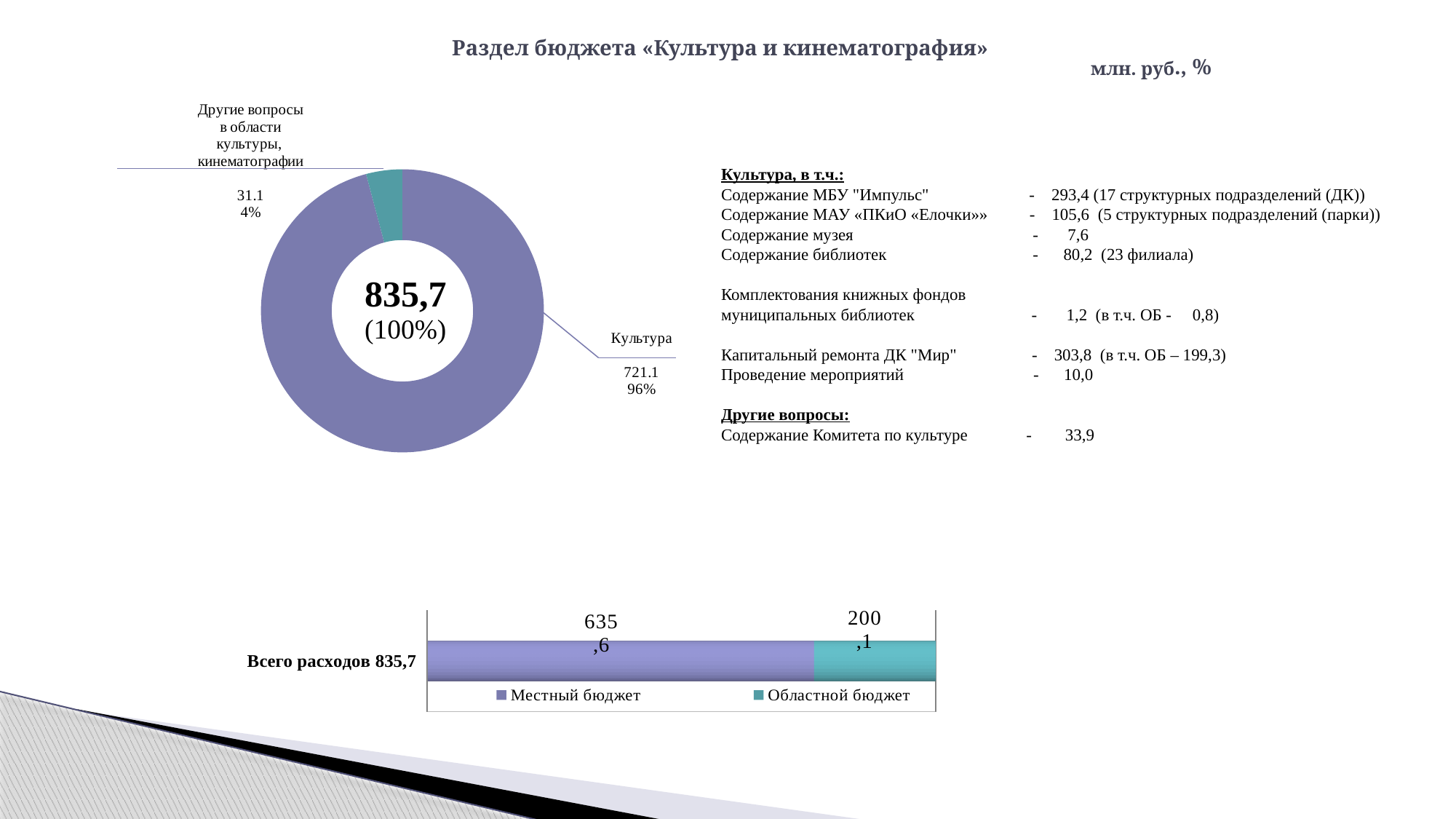
On the bar chart at the bottom of the slide, which is larger, Местный бюджет or Областной бюджет? Местный бюджет On the doughnut chart at the top left, what is the value for Другие вопросы в области культуры, кинематографии? 31.1 What kind of chart is shown at the bottom of the slide? Stacked bar chart On the bar chart at the bottom of the slide, what is the value for Местный бюджет? 635,6 On the doughnut chart at the top left, what share of the total does Другие вопросы в области культуры, кинематографии account for? 4% On the doughnut chart at the top left, which category is the largest? Культура On the doughnut chart at the top left, what is the value for Культура? 721.1 How many categories does the doughnut chart at the top left show? 2 On the bar chart at the bottom of the slide, what is the value for Областной бюджет? 200,1 On the doughnut chart at the top left, what total is shown in the centre? 835,7 How many series does the legend of the bar chart at the bottom of the slide list? 2 On the doughnut chart at the top left, what share of the total does Культура account for? 96%